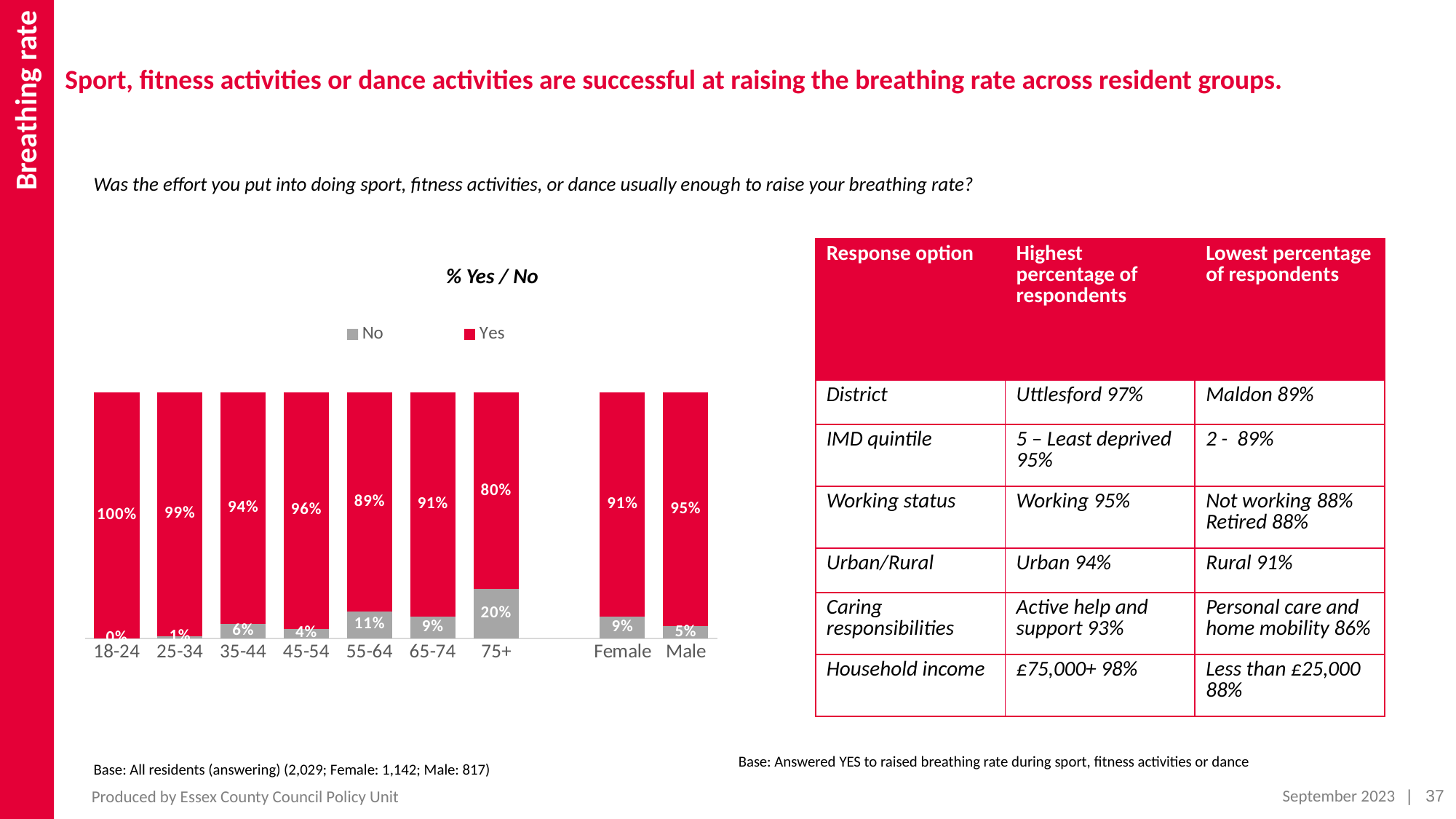
Which has a higher Yes value, the 35-44 age group or the 45-54 age group? 45-54 What is the difference between the Yes values for Male and Female respondents? 4% What is the Yes value for the 75+ age group? 80% Which category has the highest No value? 75+ How many series does the chart legend list? 2 Which category has the lowest Yes value? 75+ What is the Yes value for Male respondents? 95% How many categories are shown on the x axis of the chart? 9 What is the title of the chart? % Yes / No What is the No value for the 55-64 age group? 11% What kind of chart is shown on the slide? Stacked bar chart What is the total of the Yes and No values for the 65-74 age group? 100%